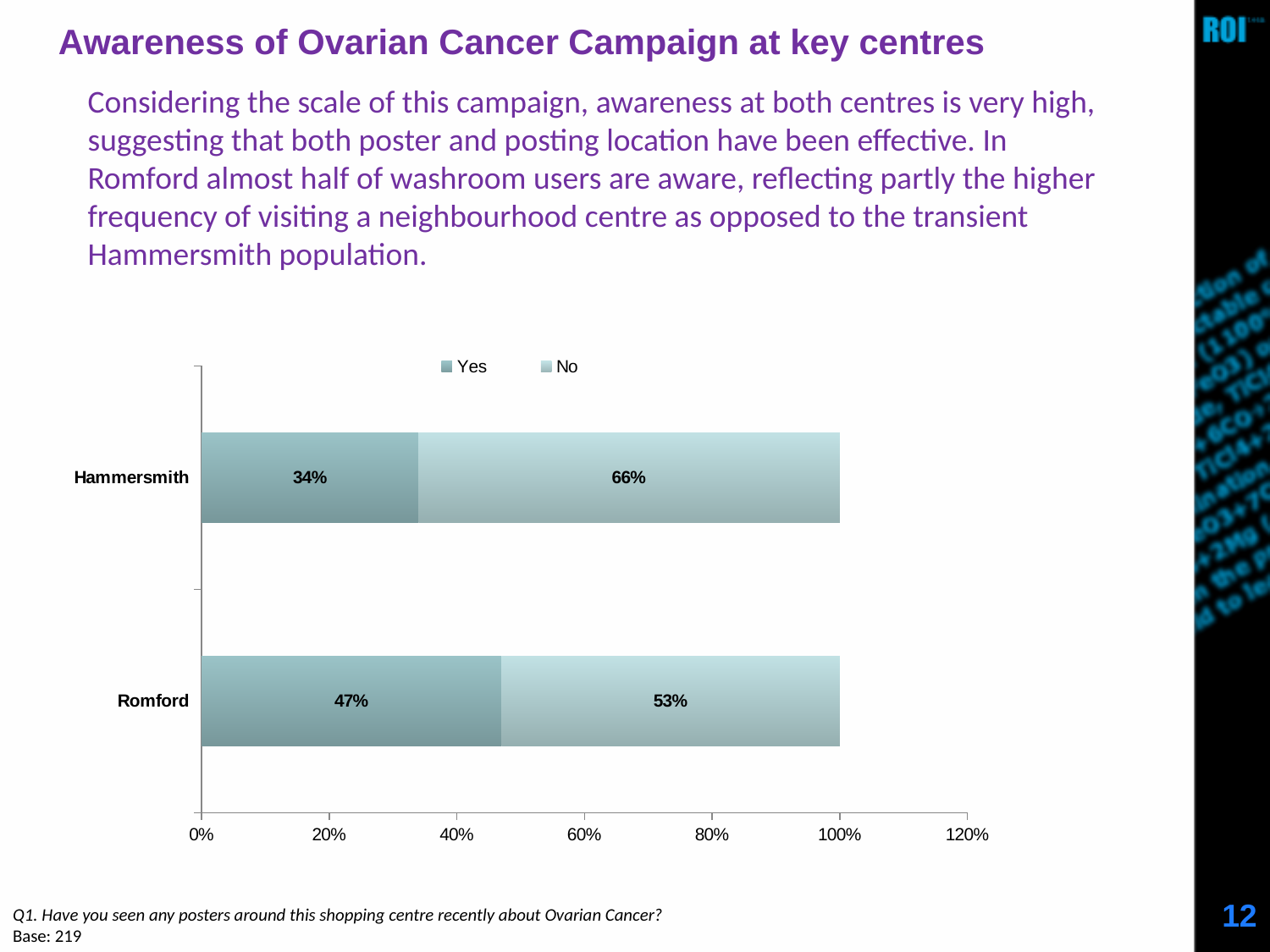
How many series does the legend list? 2 What percentage of Hammersmith respondents answered No? 66% What is the total of the Yes and No segments for the Romford bar? 100% How many centres are shown on the chart? 2 What percentage of Romford respondents answered Yes? 47% Which centre has the lower No percentage? Romford Is the No percentage for Hammersmith larger than the No percentage for Romford? Yes Which centre has the higher Yes percentage? Romford What percentage of Romford respondents answered No? 53% What percentage of Hammersmith respondents answered Yes? 34% What kind of chart is shown on the slide? Stacked bar chart What is the difference between the Yes percentages for Romford and Hammersmith? 13%